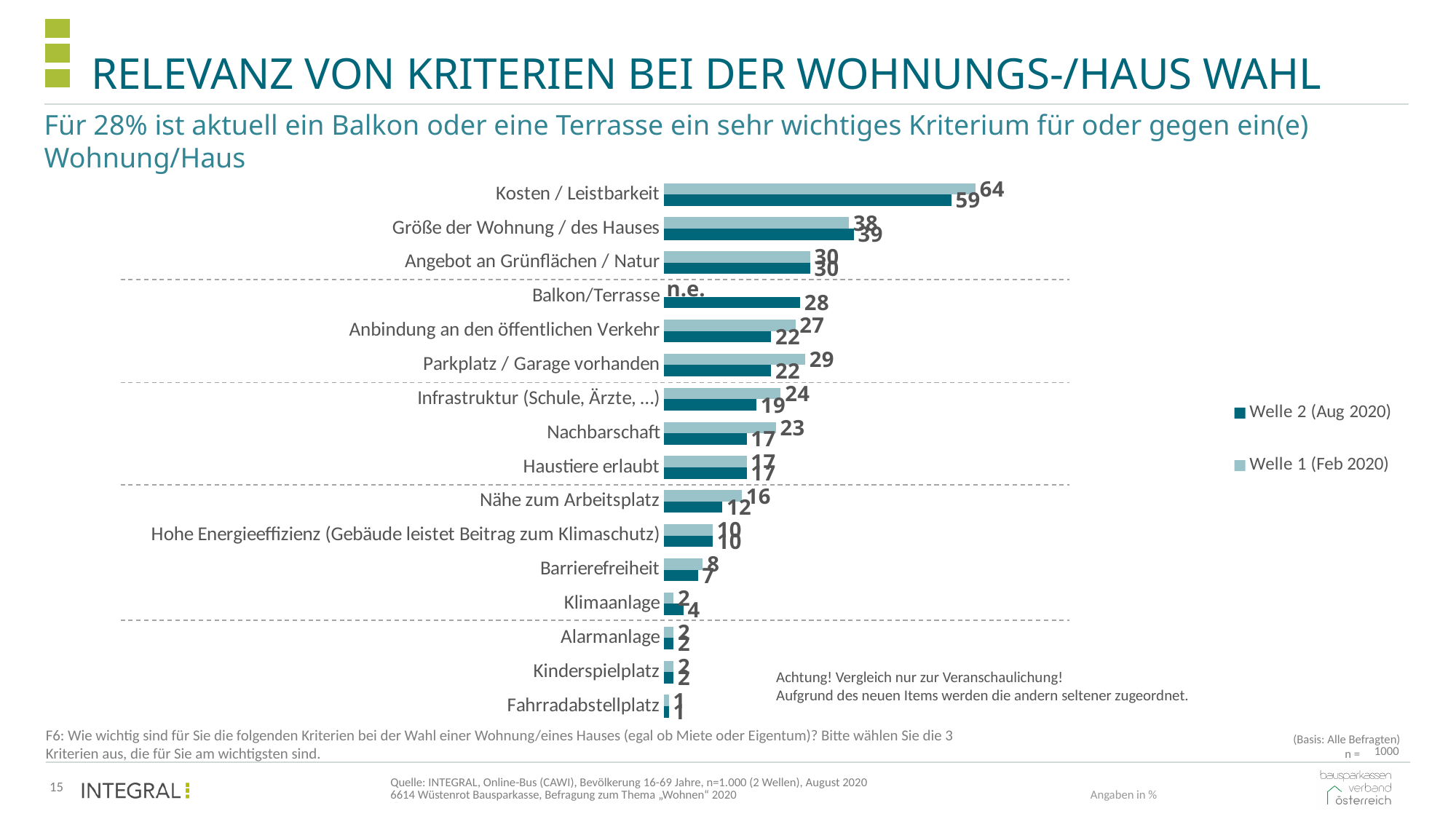
Which is larger for Nachbarschaft: the Welle 1 (Feb 2020) value or the Welle 2 (Aug 2020) value? Welle 1 (Feb 2020) How many categories are plotted on the chart? 16 What kind of chart is shown on the slide? bar chart What is the Welle 2 (Aug 2020) value for Klimaanlage? 4 What are the two series named in the legend? Welle 2 (Aug 2020) and Welle 1 (Feb 2020) Which category has the highest value in Welle 2 (Aug 2020)? Kosten / Leistbarkeit What is the Welle 2 (Aug 2020) value for Balkon/Terrasse? 28 What is the difference between the Welle 1 (Feb 2020) and Welle 2 (Aug 2020) values for Parkplatz / Garage vorhanden? 7 What is the Welle 1 (Feb 2020) value for Kosten / Leistbarkeit? 64 What is shown for Balkon/Terrasse in Welle 1 (Feb 2020)? n.e. What is the Welle 2 (Aug 2020) value for Kosten / Leistbarkeit? 59 How many series does the legend list? 2